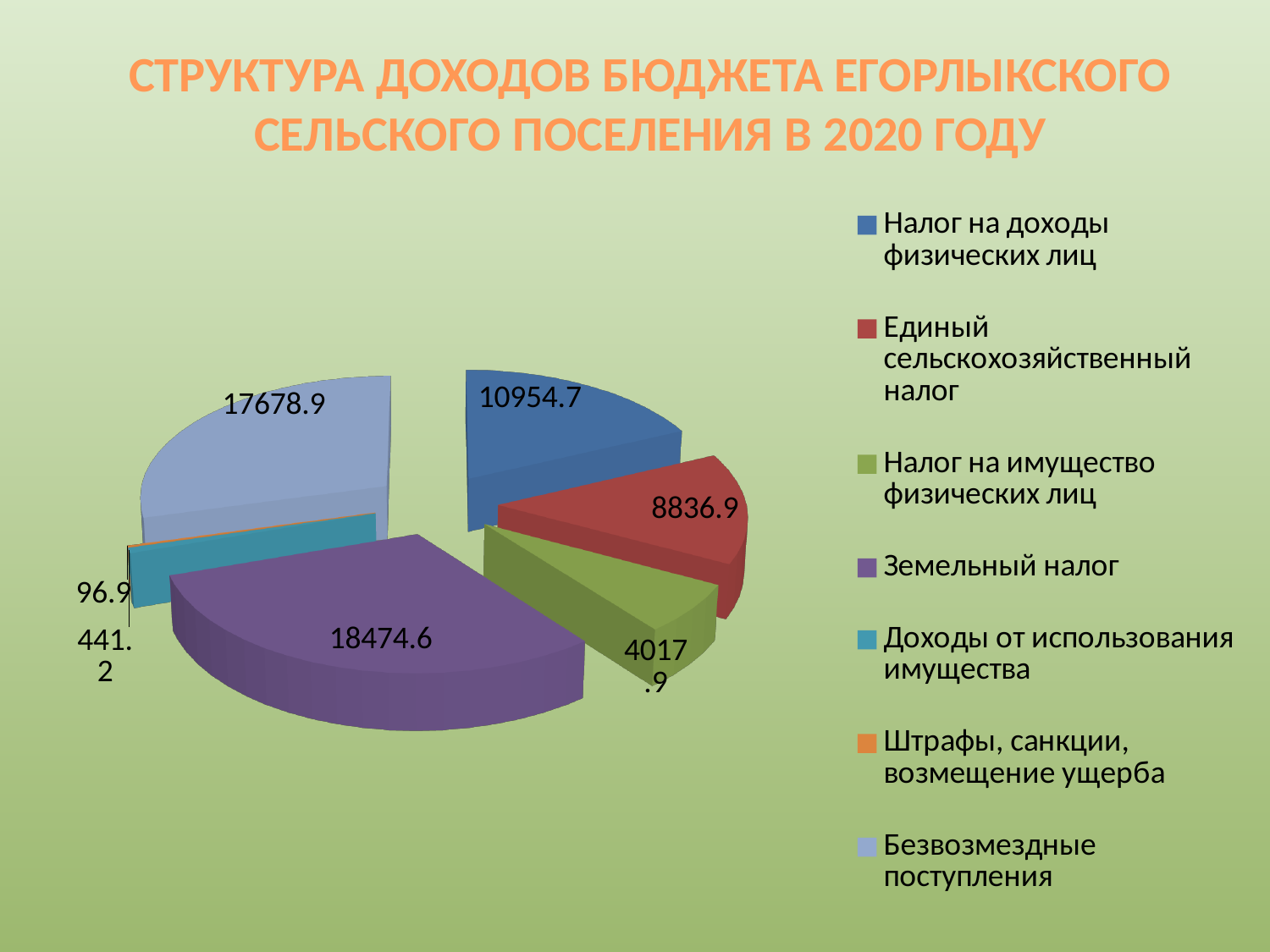
What is the value for Налог на доходы физических лиц? 10954.7 What is the value for Земельный налог? 18474.6 What is the value for Безвозмездные поступления? 17678.9 What is the value for Налог на имущество физических лиц? 4017.9 Which is larger: Налог на доходы физических лиц or Единый сельскохозяйственный налог? Налог на доходы физических лиц How many categories does the legend list? 7 What is the title of the chart? СТРУКТУРА ДОХОДОВ БЮДЖЕТА ЕГОРЛЫКСКОГО СЕЛЬСКОГО ПОСЕЛЕНИЯ В 2020 ГОДУ Which category has the largest value? Земельный налог What is the difference between Земельный налог and Безвозмездные поступления? 795.7 What is the value for Единый сельскохозяйственный налог? 8836.9 What type of chart is shown on the slide? Pie chart Which category has the smallest value? Штрафы, санкции, возмещение ущерба